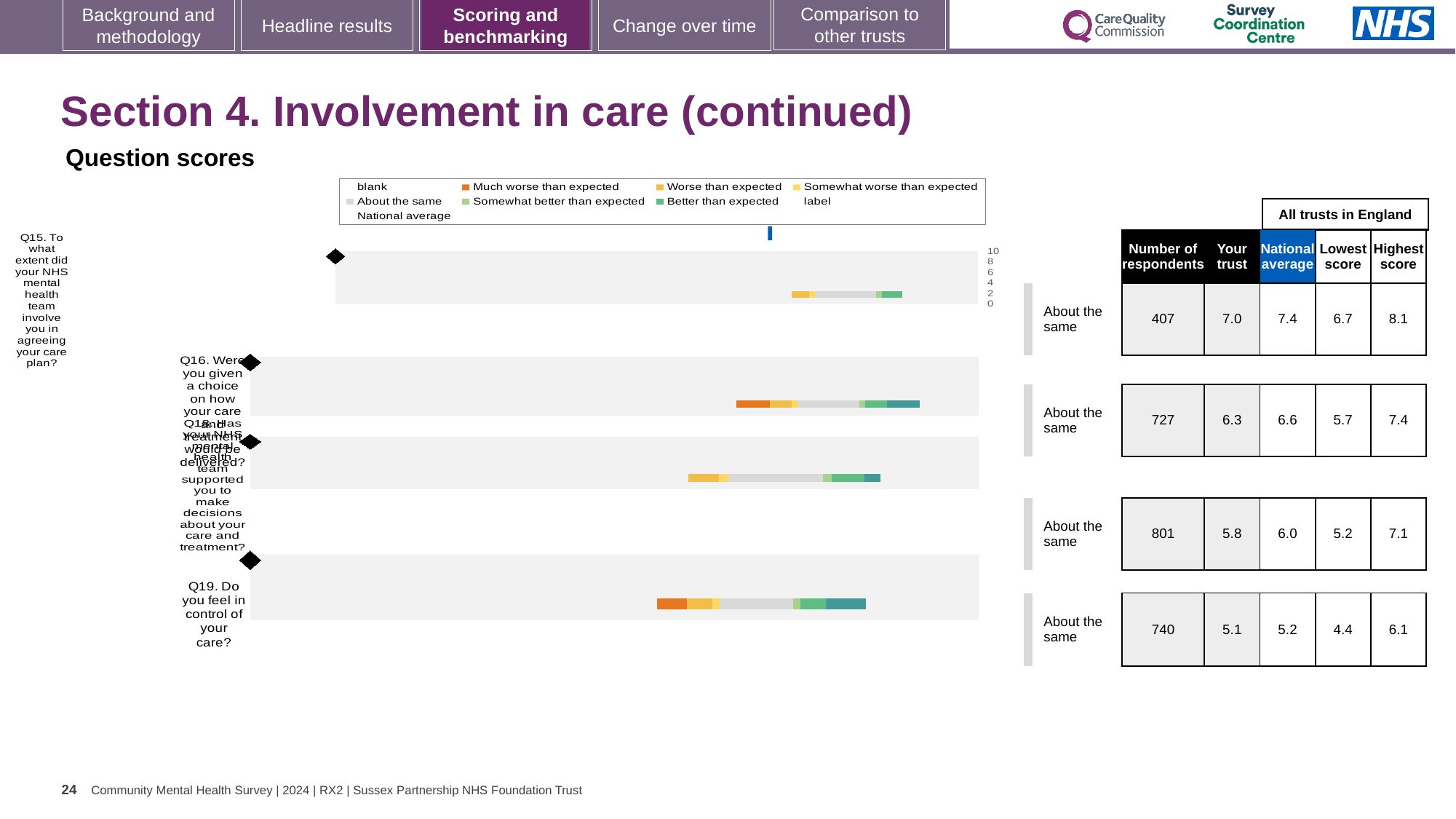
What kind of chart is used to show the question scores on this slide? bar chart What benchmark category is shown for Q19 in the question scores chart? About the same How many questions (bars) are plotted in the question scores chart? 4 What is the 'Your trust' score for Q15 (involvement in agreeing your care plan)? 7.0 What is the lowest score across all trusts in England for Q19? 4.4 For Q16, which is larger: the 'Your trust' score or the national average? National average What is the difference between the national average and the 'Your trust' score for Q15? 0.4 Which question has the highest 'Your trust' score? Q15 What is the national average score for Q19 (Do you feel in control of your care?)? 5.2 What is the highest score across all trusts in England for Q18? 7.1 Which question has the lowest 'Your trust' score? Q19 How many respondents answered Q16 (choice on how care and treatment would be delivered)? 727